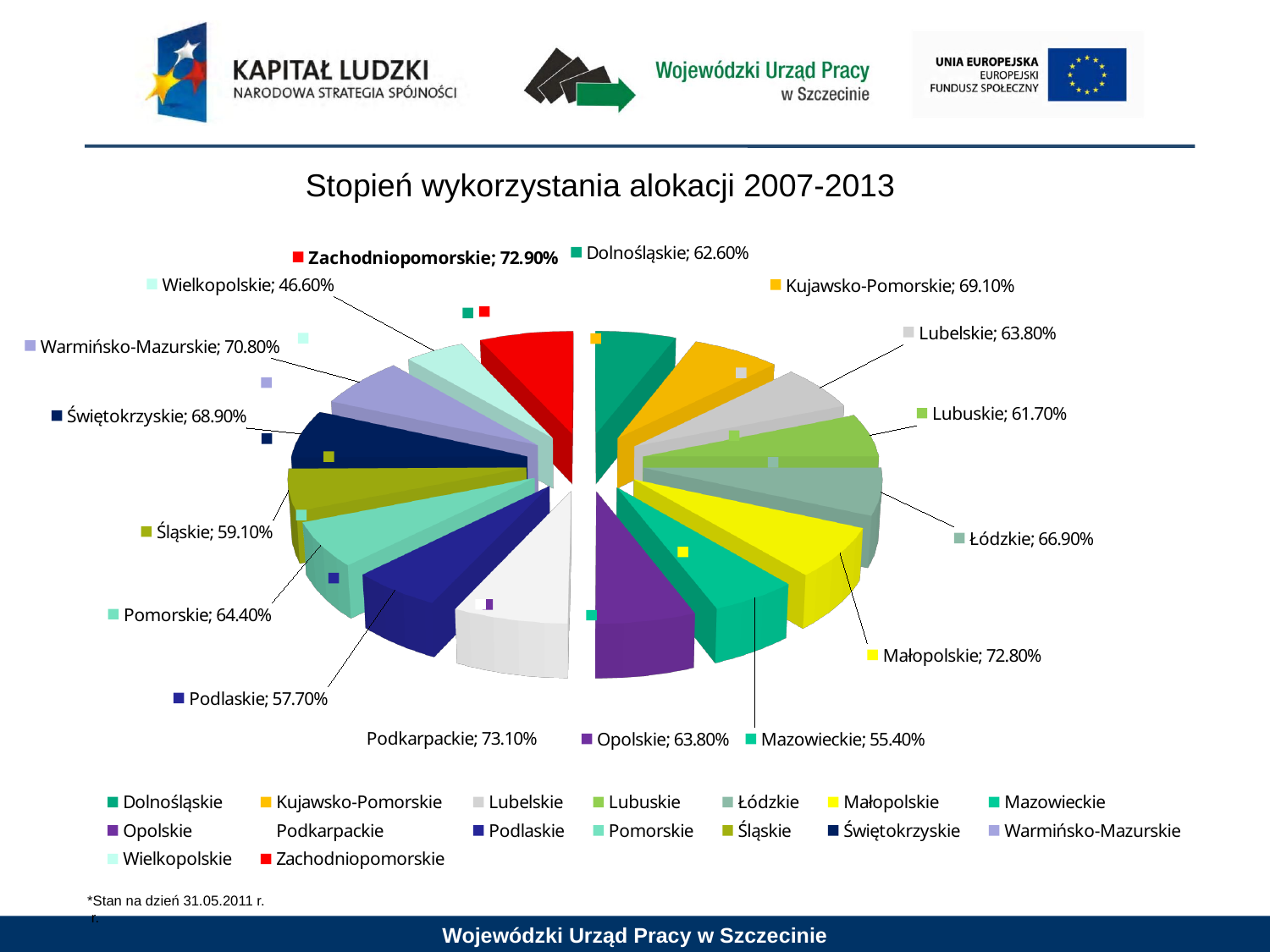
What is the value shown for Zachodniopomorskie? 72.90% Which region has the lowest value in the chart? Wielkopolskie How many regions are shown in the pie chart? 16 What is the value shown for Wielkopolskie? 46.60% What is the difference between the values for Podkarpackie and Wielkopolskie? 26.50 percentage points What is the difference between the values for Kujawsko-Pomorskie and Dolnośląskie? 6.50 percentage points What kind of chart is shown on the slide? Pie chart Which has a larger value, Świętokrzyskie or Śląskie? Świętokrzyskie What is the value shown for Warmińsko-Mazurskie? 70.80% What is the title of the chart? Stopień wykorzystania alokacji 2007-2013 Which region has the highest value in the chart? Podkarpackie What is the value shown for Mazowieckie? 55.40%